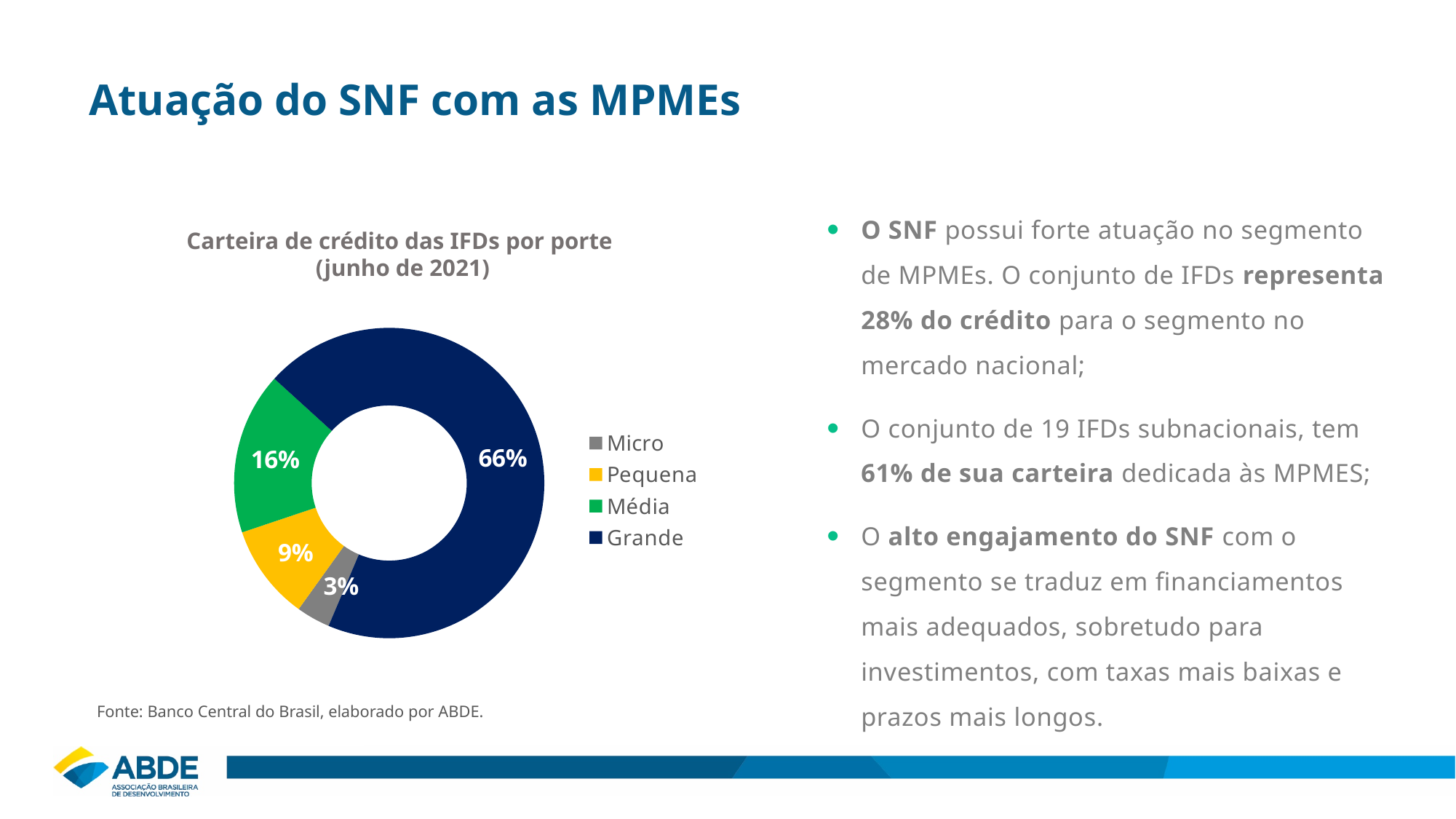
What share of the credit portfolio does the Micro segment hold? 3% Which segment has a larger share, Pequena or Média? Média What kind of chart is shown on the slide? Doughnut (pie) chart Which segment has the largest share of the credit portfolio? Grande What share of the credit portfolio does the Grande segment hold? 66% What colour represents the Pequena segment in the chart? Yellow What is the difference in percentage points between the Grande and Média shares? 50 What is the title of the chart? Carteira de crédito das IFDs por porte (junho de 2021) What share of the credit portfolio does the Média segment hold? 16% What share of the credit portfolio does the Pequena segment hold? 9% How many segments are shown in the chart? 4 Which segment has the smallest share of the credit portfolio? Micro